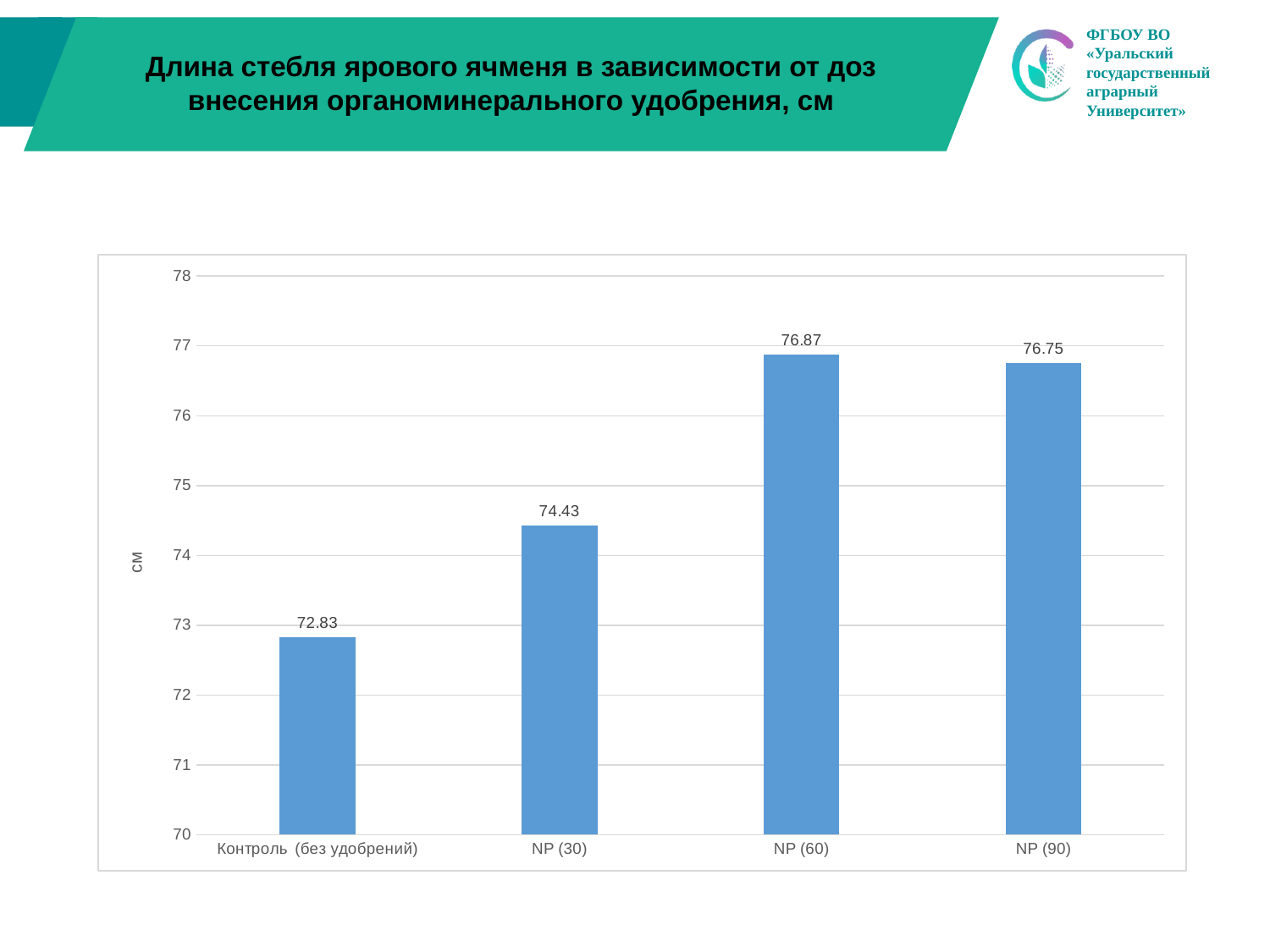
Which is larger, the value for NP (30) or the value for NP (90)? NP (90) Which category has the highest value? NP (60) What is the difference between the values for NP (60) and Контроль (без удобрений)? 4.04 Which category has the lowest value? Контроль (без удобрений) What is the value shown for NP (30)? 74.43 What kind of chart is shown on the slide? bar chart How many categories are shown on the x axis? 4 What is the value shown for Контроль (без удобрений)? 72.83 What is the stem length value for NP (60)? 76.87 What is the difference between the values for NP (30) and Контроль (без удобрений)? 1.6 Is the value for NP (30) greater or less than 75? less What is the label of the vertical axis? см